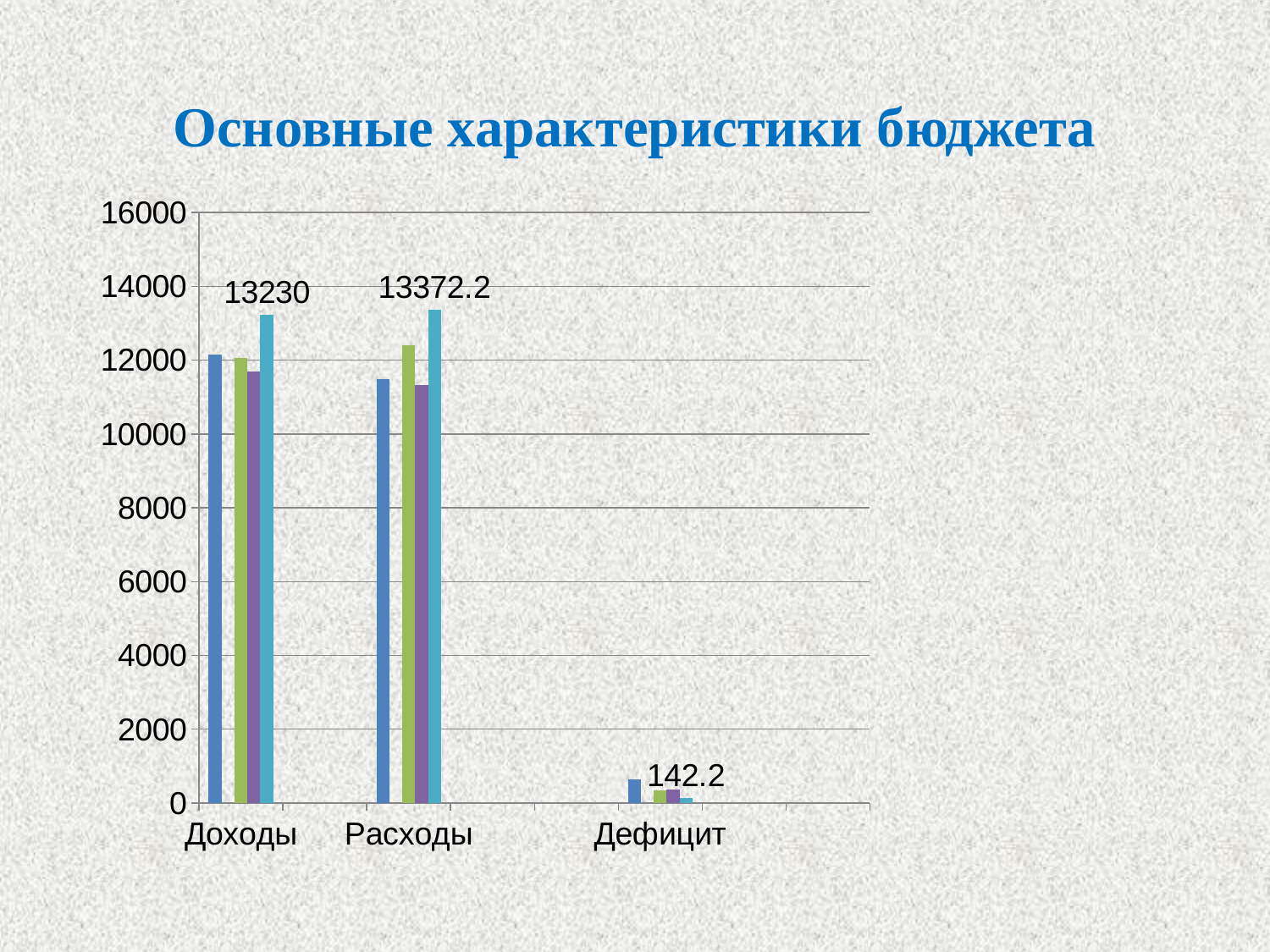
What is the difference between the labelled values for Расходы and Доходы? 142.2 How many categories are shown on the x axis of the chart? 3 What is the title of the slide above the chart? Основные характеристики бюджета Are the values for Дефицит greater or less than 2000? less Which category has the lowest values in the chart? Дефицит What is the labelled value shown for Расходы? 13372.2 What kind of chart is shown on the slide? bar chart How many bars are plotted for each category? 4 What is the labelled value shown for Дефицит? 142.2 What is the labelled value shown for Доходы? 13230 Are the values for Доходы greater or less than 10000? greater Which has the larger labelled value, Доходы or Расходы? Расходы